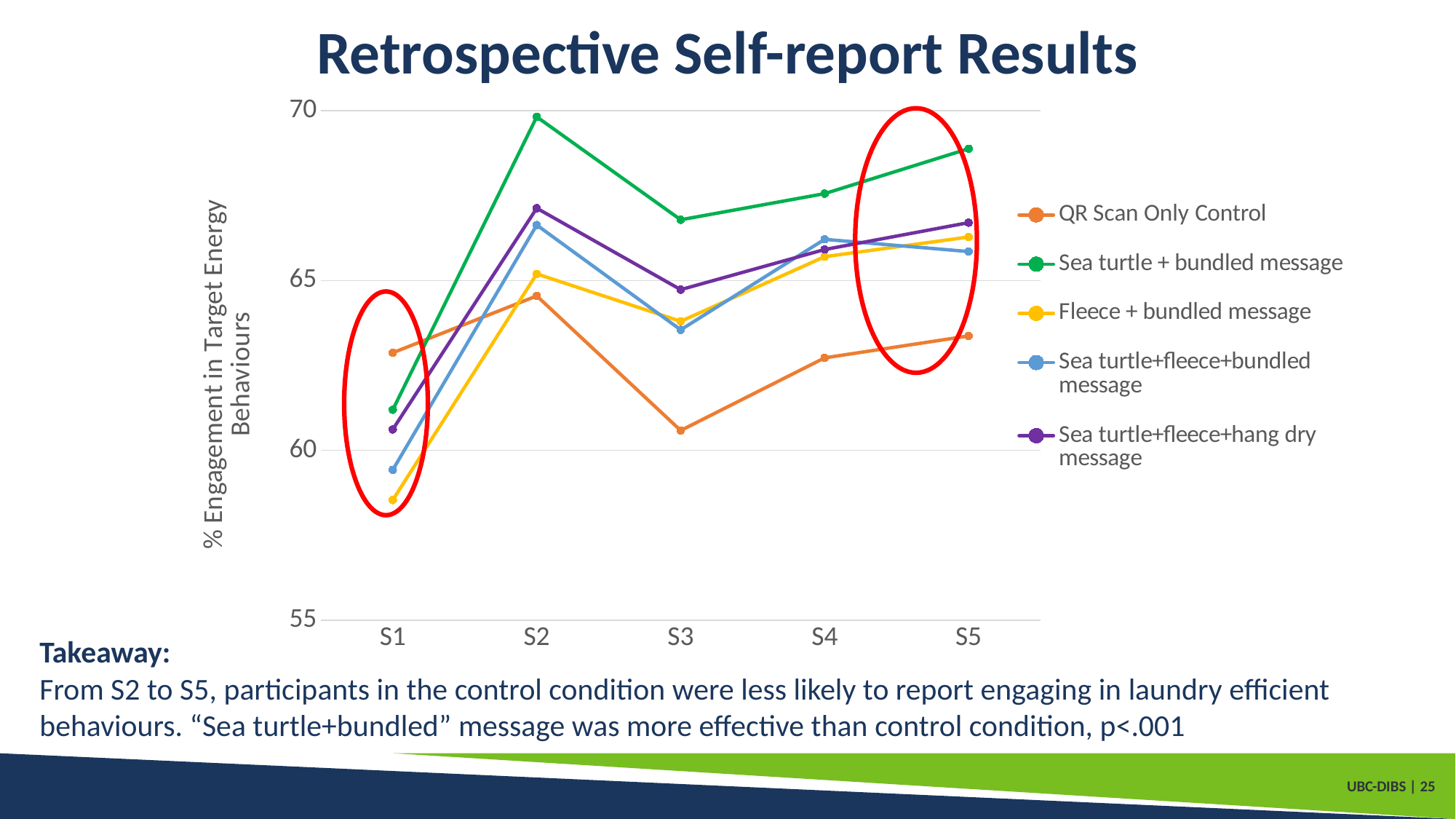
Is the value for Fleece + bundled message at S1 greater or less than 60? less What kind of chart is shown on the slide? line chart How many series does the legend list? 5 At which session is the QR Scan Only Control series at its lowest? S3 Which series has the lowest value at S1? Fleece + bundled message Is the value for Sea turtle + bundled message at S2 greater or less than 65? greater Is the value for QR Scan Only Control at S3 greater or less than 65? less How many sessions are shown along the x axis? 5 At which session does the Sea turtle + bundled message series reach its highest value? S2 Which series has the highest value at S2? Sea turtle + bundled message What is the label on the y axis? % Engagement in Target Energy Behaviours At S5, which is larger: QR Scan Only Control or Sea turtle + bundled message? Sea turtle + bundled message